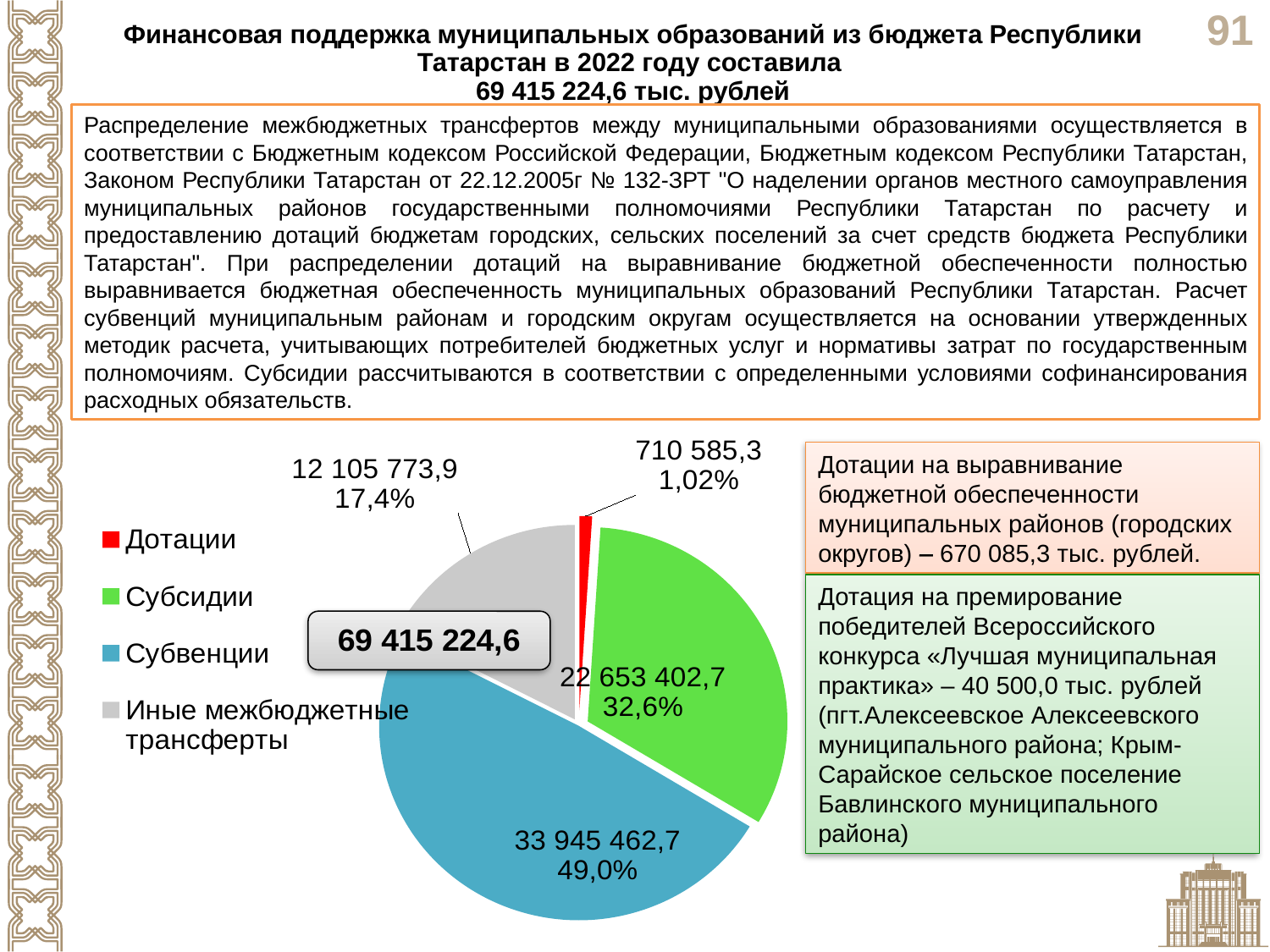
What value is shown for Дотации in the pie chart? 710 585,3 What share of the pie does Дотации represent? 1,02% Which category has the largest slice in the pie chart? Субвенции What share of the pie does Субвенции represent? 49,0% How many slices does the pie chart have? 4 How many entries does the legend of the pie chart list? 4 What kind of chart is shown on the slide? Pie chart Which is larger in the pie chart, Субсидии or Иные межбюджетные трансферты? Субсидии Which category has the smallest slice in the pie chart? Дотации What value is shown for Иные межбюджетные трансферты in the pie chart? 12 105 773,9 What value is shown for Субвенции in the pie chart? 33 945 462,7 What value is shown for Субсидии in the pie chart? 22 653 402,7